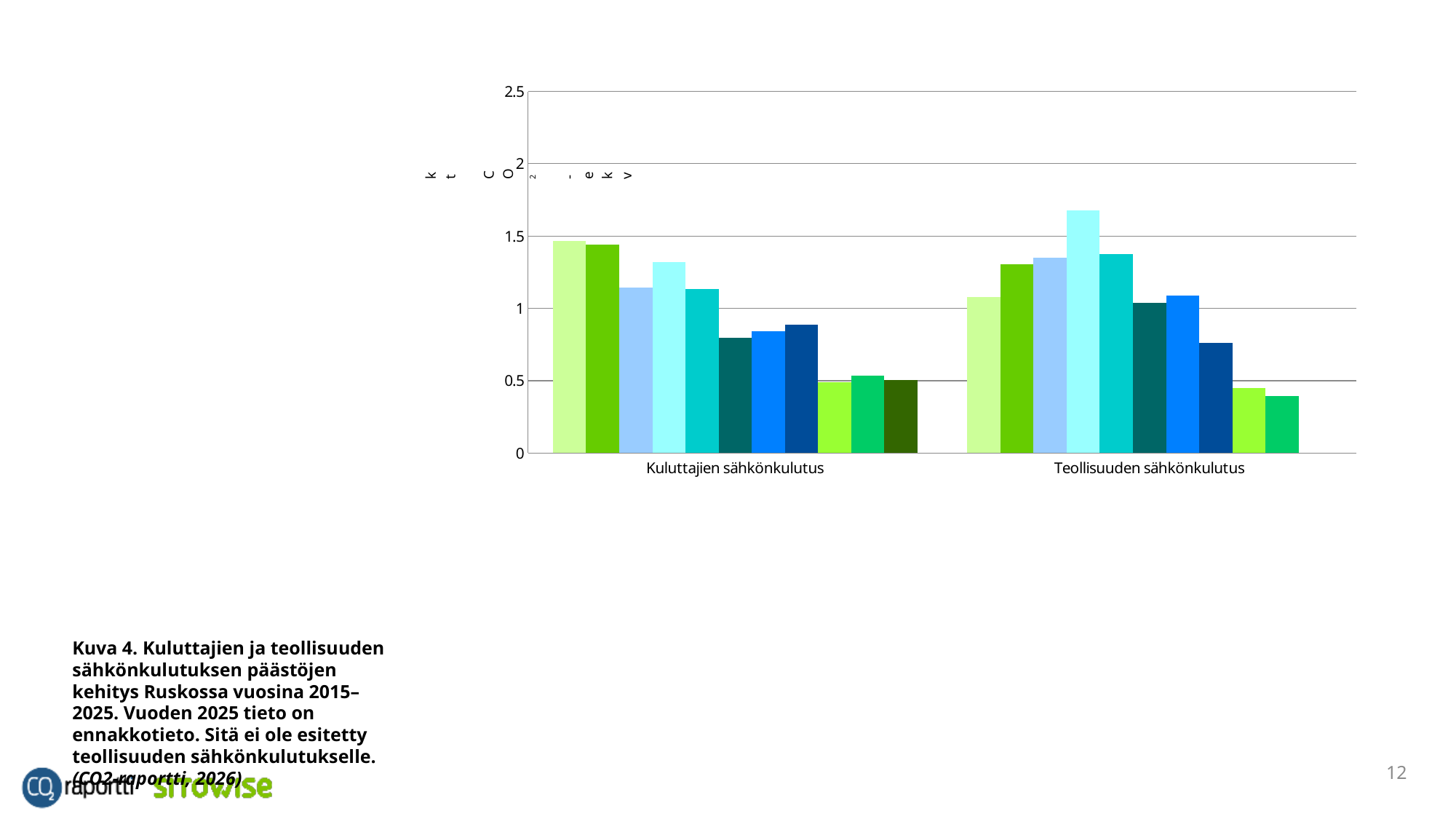
What is the highest value shown on the y axis of the chart? 2.5 How many categories are shown on the x axis of the chart? 2 How many bars are plotted in the Kuluttajien sähkönkulutus group? 11 How many bars are plotted in the Teollisuuden sähkönkulutus group? 10 Is the value of the leftmost bar in the Kuluttajien sähkönkulutus group greater or less than 1? greater Do the bars in the Kuluttajien sähkönkulutus group generally rise or fall from left to right? fall Is the value of the rightmost bar in the Kuluttajien sähkönkulutus group greater or less than 1? less Which category is labelled on the left side of the x axis? Kuluttajien sähkönkulutus What kind of chart is shown on the slide? bar chart Is the value of the tallest bar in the Teollisuuden sähkönkulutus group greater or less than 1.5? greater Which group contains the tallest bar on the chart, Kuluttajien sähkönkulutus or Teollisuuden sähkönkulutus? Teollisuuden sähkönkulutus